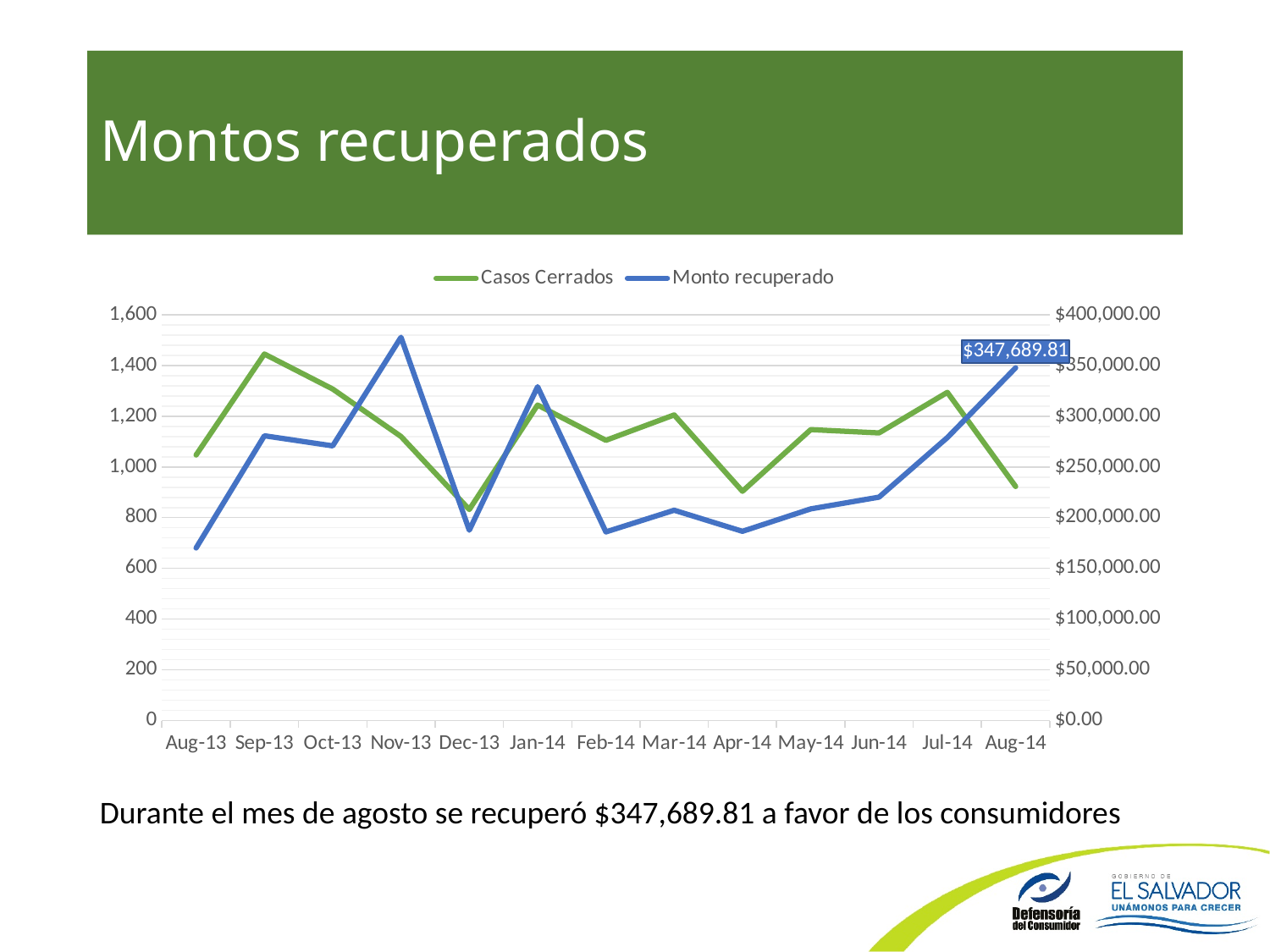
In which month is Casos Cerrados lowest? Dec-13 Is the Casos Cerrados value for Dec-13 greater or less than 1,000? less What is the Monto recuperado value shown for Aug-14? $347,689.81 In which month is Monto recuperado highest? Nov-13 Is the Monto recuperado value for Aug-13 greater or less than $200,000.00? less How many series does the legend list? 2 Does Monto recuperado rise or fall from Apr-14 to Aug-14? Rise How many months are plotted along the x axis? 13 Which is larger, Casos Cerrados in Sep-13 or in Aug-14? Sep-13 What kind of chart is shown on the slide? Line chart In which month is Casos Cerrados highest? Sep-13 In which month is Monto recuperado lowest? Aug-13